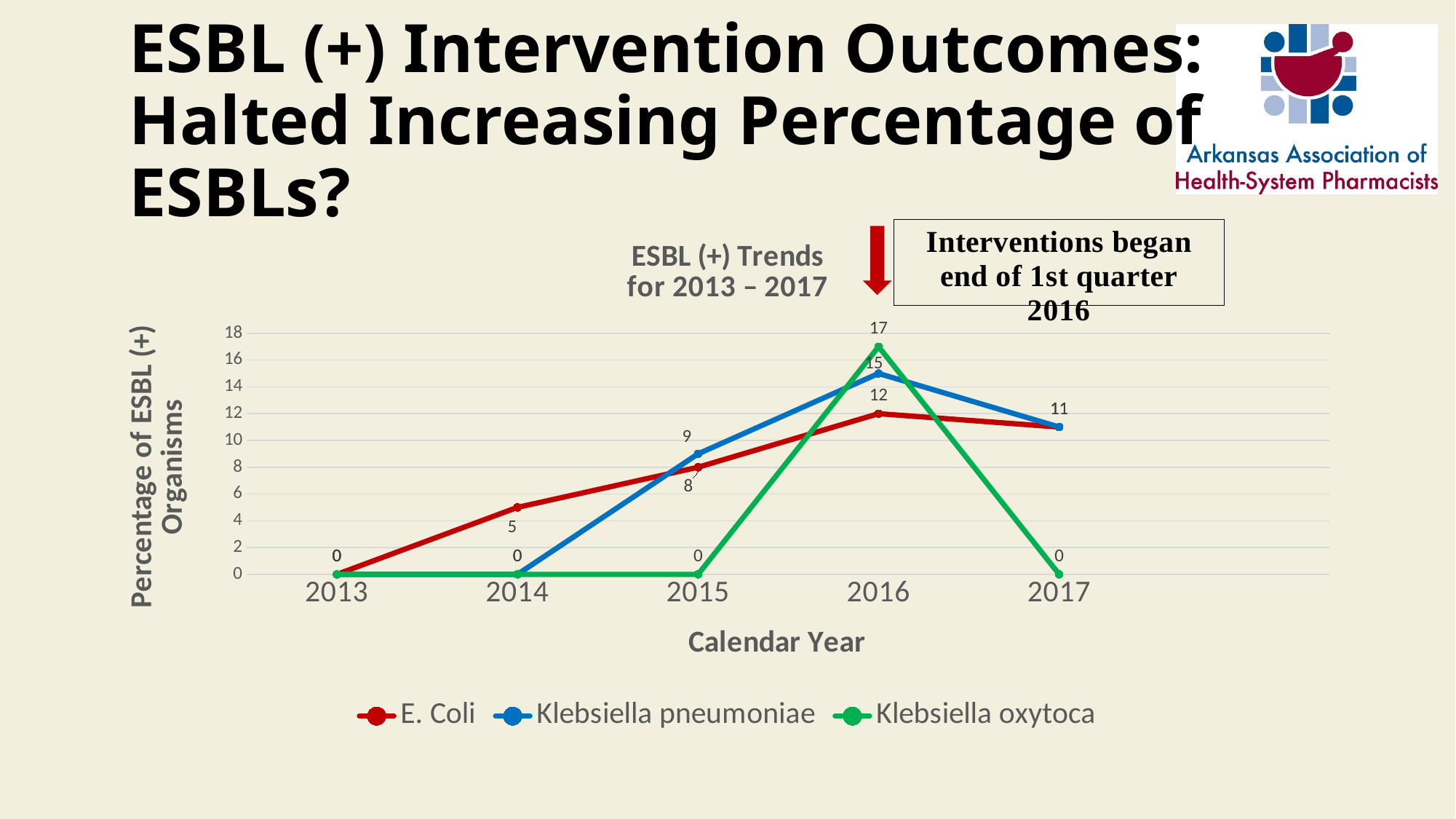
In which year does E. Coli reach its highest value? 2016 What kind of chart is shown on the slide? line chart What is the value for Klebsiella pneumoniae in 2015? 9 What is the value for E. Coli in 2014? 5 How many calendar years are plotted on the x axis of the chart? 5 In 2015, which is larger: the value for E. Coli or for Klebsiella pneumoniae? Klebsiella pneumoniae How many series does the legend of the ESBL (+) Trends chart list? 3 What is the difference between the Klebsiella oxytoca and Klebsiella pneumoniae values in 2016? 2 Which series has the highest value in 2016? Klebsiella oxytoca What is the value for Klebsiella oxytoca in 2017? 0 Does the E. Coli line rise or fall from 2013 to 2016? rise What is the value for Klebsiella oxytoca in 2016? 17